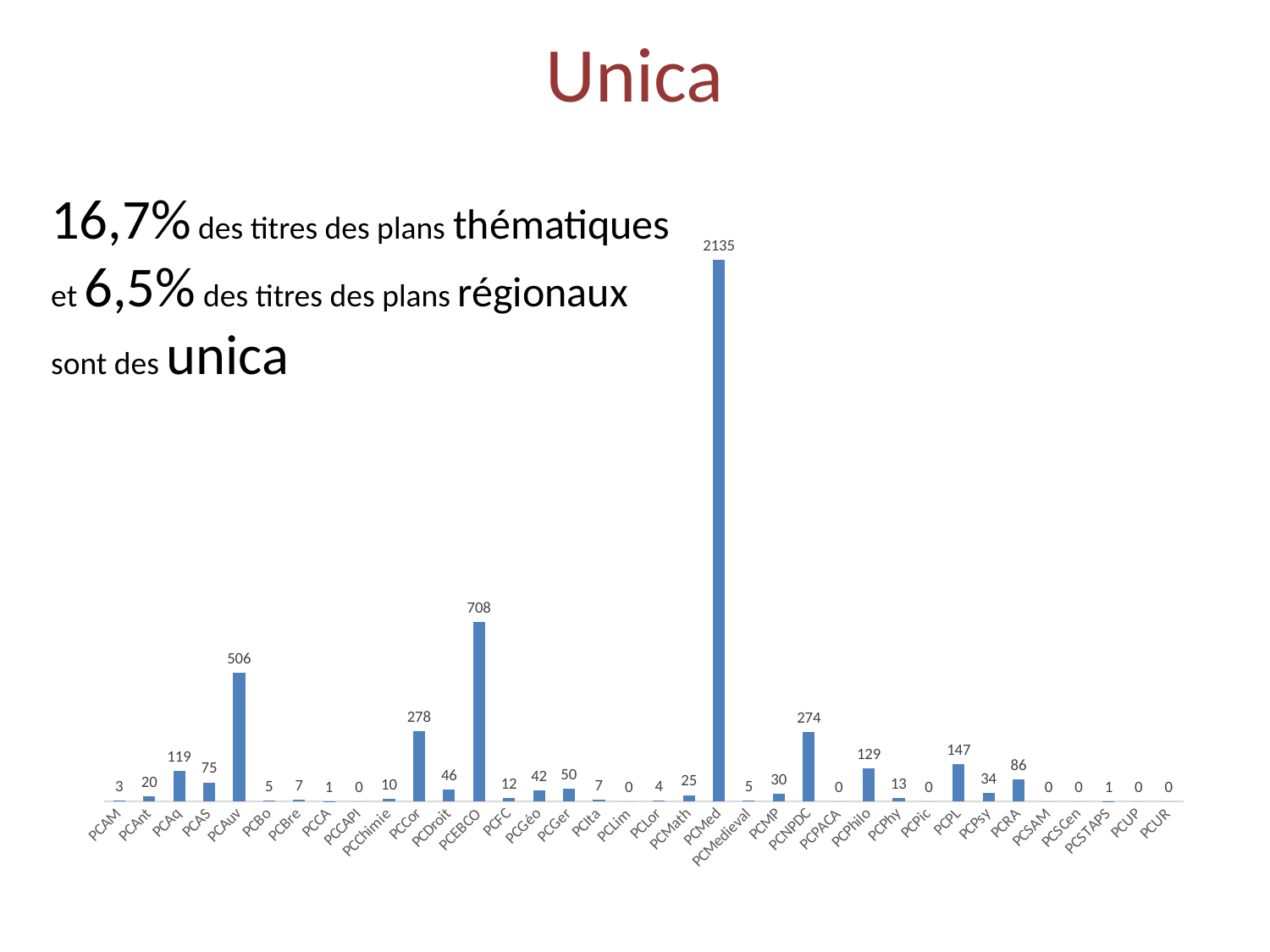
What is the value for PCMed? 2135 What is the value for PCAuv? 506 What is the value for PCPhilo? 129 Which is larger, the value for PCAq or the value for PCAS? PCAq What is the value for PCEBCO? 708 What is the value for PCNPDC? 274 What is the difference between the values for PCEBCO and PCAuv? 202 Which category has the highest value? PCMed How many categories are shown on the x axis? 36 How many categories have a value of 0? 8 What kind of chart is shown on the slide? bar chart What is the difference between the values for PCMed and PCEBCO? 1427